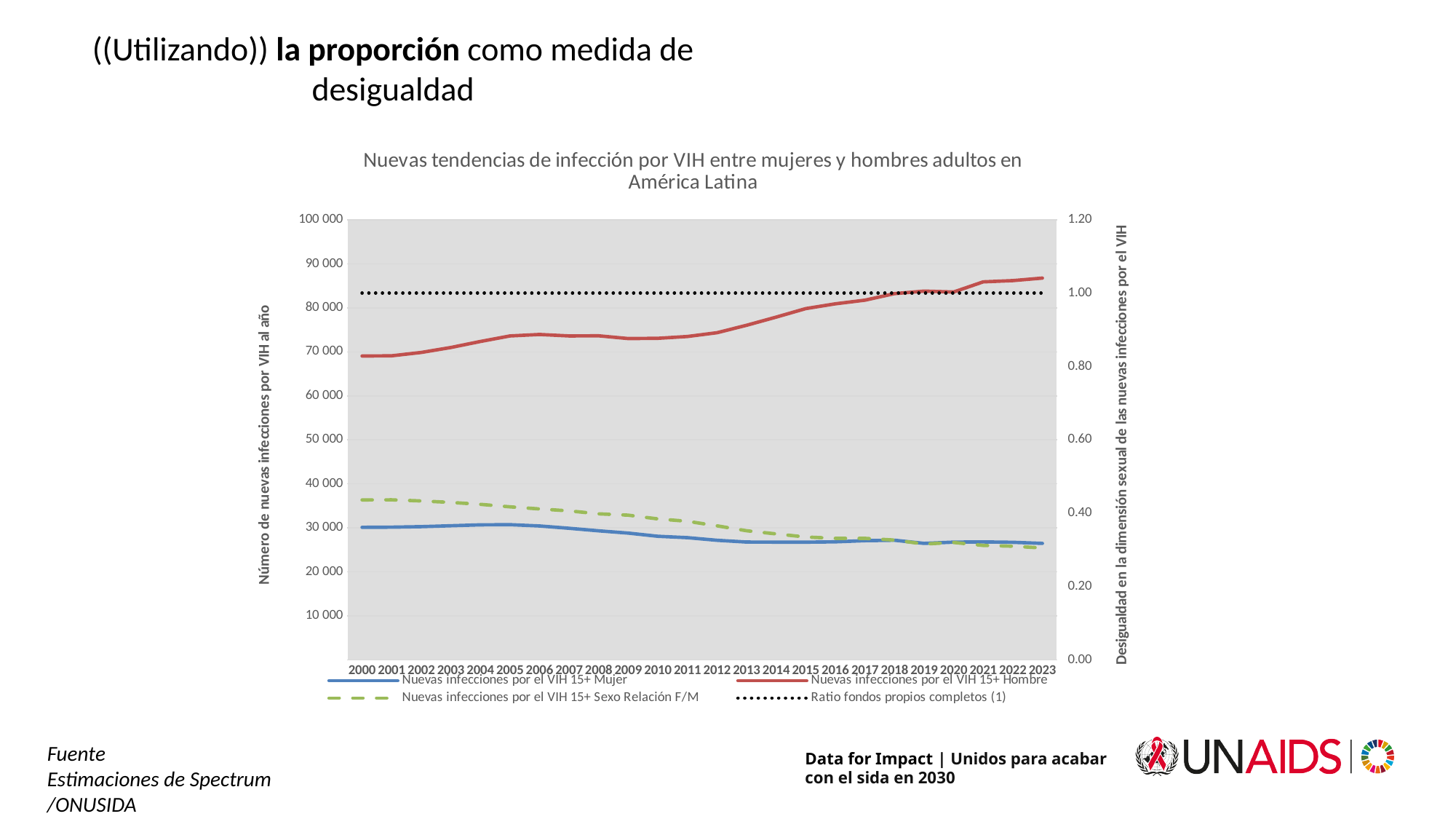
Is the value for 'Nuevas infecciones por el VIH 15+ Sexo Relación F/M' in 2023 greater or less than 0.40 on the right axis? less In 2023, which is larger: new HIV infections among 'Hombre' or among 'Mujer'? Hombre At what value on the right axis does the dotted line 'Ratio fondos propios completos (1)' sit? 1.00 Does the dashed line for 'Nuevas infecciones por el VIH 15+ Sexo Relación F/M' rise or fall from 2000 to 2023? fall Does the line for 'Nuevas infecciones por el VIH 15+ Hombre' rise or fall from 2000 to 2023? rise In which year is the value for 'Nuevas infecciones por el VIH 15+ Hombre' highest? 2023 How many years are shown along the x axis of the chart? 24 Is the value for 'Nuevas infecciones por el VIH 15+ Mujer' in 2000 greater or less than 40 000? less Is the value for 'Nuevas infecciones por el VIH 15+ Hombre' in 2023 greater or less than 80 000? greater What kind of chart is shown on the slide? line chart How many series does the chart legend list? 4 What is the title of the chart? Nuevas tendencias de infección por VIH entre mujeres y hombres adultos en América Latina